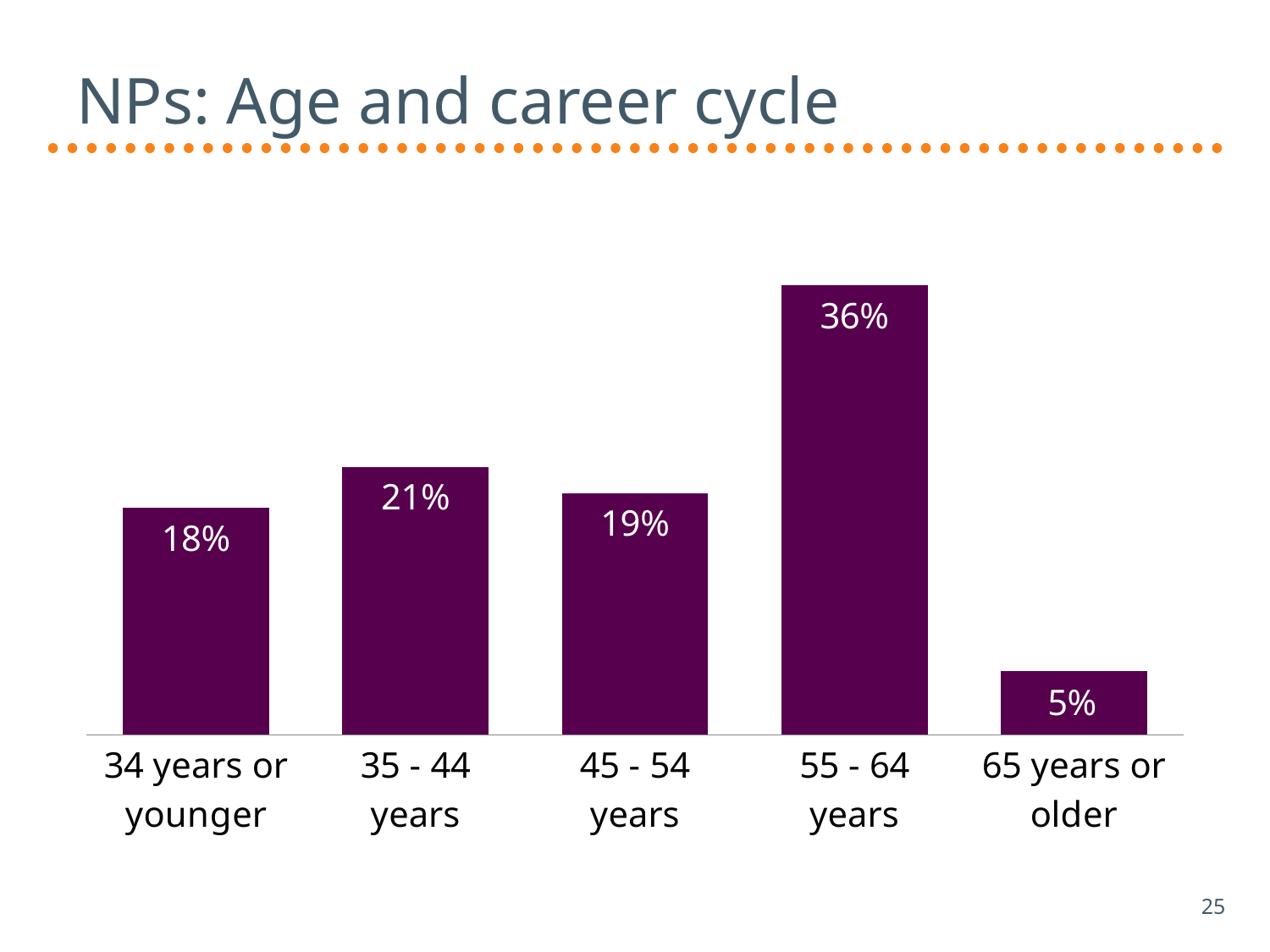
What is the title of the slide? NPs: Age and career cycle What is the value for 45 - 54 years? 19% What kind of chart is shown on the slide? Bar chart What is the difference between the values for 34 years or younger and 65 years or older? 13% What is the difference between the values for 55 - 64 years and 35 - 44 years? 15% What is the value for 65 years or older? 5% What is the value for 34 years or younger? 18% What is the value for 55 - 64 years? 36% Which age group has the highest value? 55 - 64 years Which is larger, the value for 35 - 44 years or the value for 45 - 54 years? 35 - 44 years How many age groups are shown in the chart? 5 Which age group has the lowest value? 65 years or older